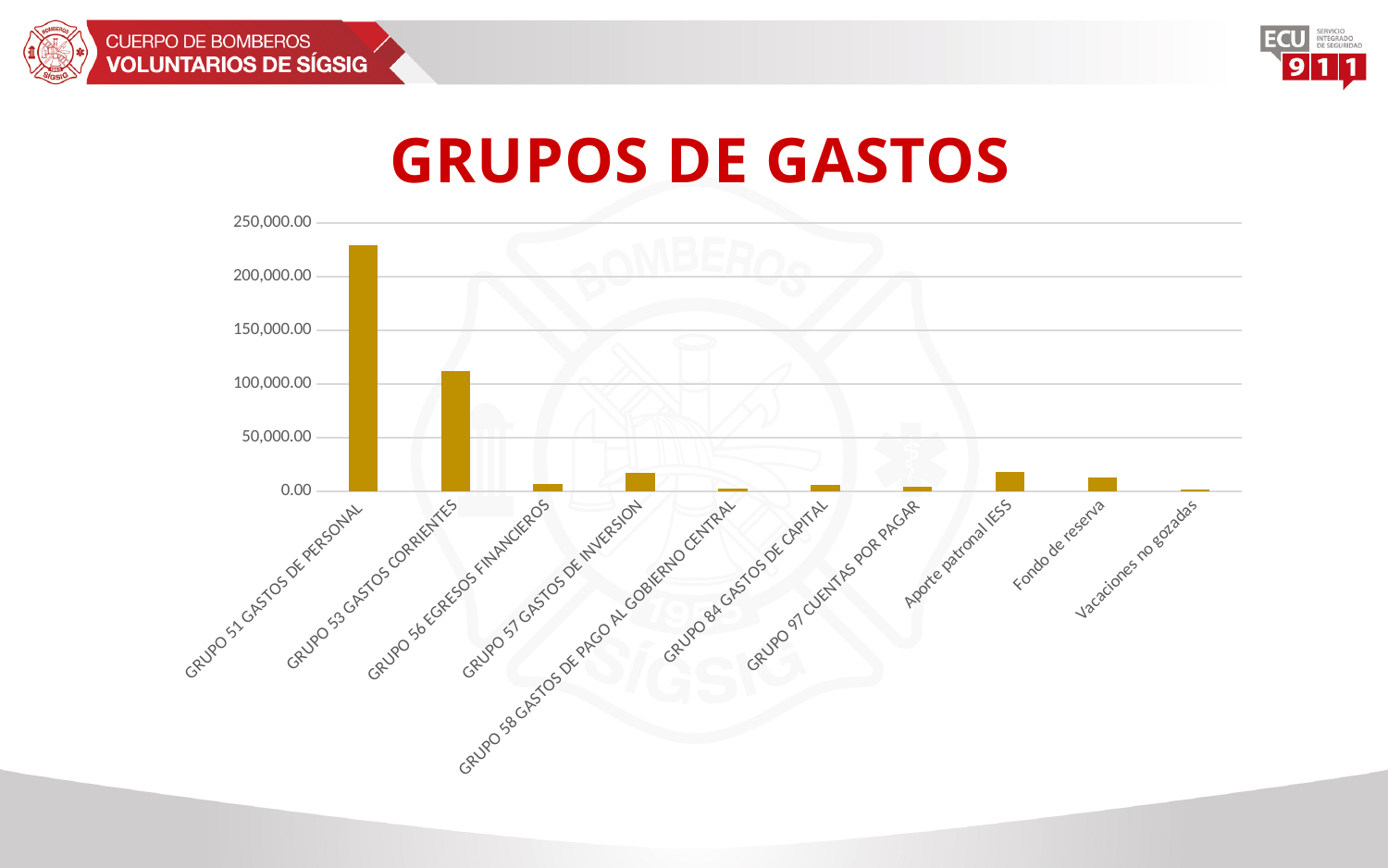
Is the value for GRUPO 51 GASTOS DE PERSONAL greater or less than 200,000.00? greater What kind of chart is shown on the slide? Bar chart Which is larger, the value for GRUPO 51 GASTOS DE PERSONAL or GRUPO 53 GASTOS CORRIENTES? GRUPO 51 GASTOS DE PERSONAL Which is larger, the value for Aporte patronal IESS or Fondo de reserva? Aporte patronal IESS Is the value for GRUPO 53 GASTOS CORRIENTES greater or less than 150,000.00? less Which is larger, the value for GRUPO 57 GASTOS DE INVERSION or GRUPO 56 EGRESOS FINANCIEROS? GRUPO 57 GASTOS DE INVERSION Which category has the highest value in the chart? GRUPO 51 GASTOS DE PERSONAL How many categories are shown on the x axis of the chart? 10 What is the highest value shown on the vertical axis of the chart? 250,000.00 Is the value for GRUPO 57 GASTOS DE INVERSION greater or less than 50,000.00? less What is the title of the chart? GRUPOS DE GASTOS